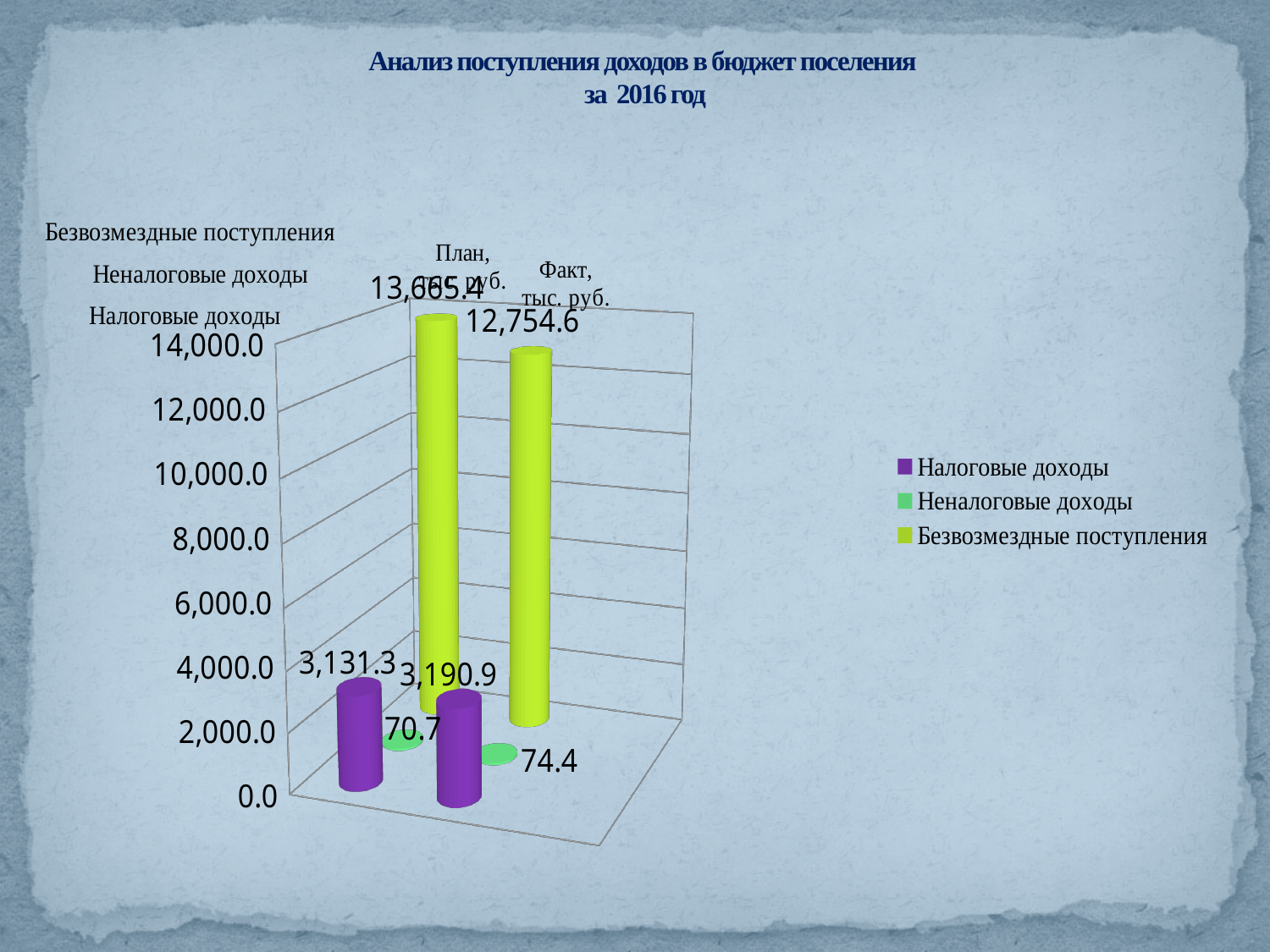
What is the difference between the План and Факт values for Безвозмездные поступления? 910.8 What kind of chart is shown on the slide? Bar chart Which series has the lowest value for План, тыс. руб.? Неналоговые доходы What is the value of Безвозмездные поступления for План, тыс. руб.? 13,665.4 Is the value of Безвозмездные поступления larger for План, тыс. руб. or for Факт, тыс. руб.? План, тыс. руб. What is the value of Налоговые доходы for Факт, тыс. руб.? 3,190.9 Which series has the highest value for Факт, тыс. руб.? Безвозмездные поступления What is the value of Неналоговые доходы for Факт, тыс. руб.? 74.4 What is the value of Налоговые доходы for План, тыс. руб.? 3,131.3 What is the value of Безвозмездные поступления for Факт, тыс. руб.? 12,754.6 How many series does the legend list? 3 What is the value of Неналоговые доходы for План, тыс. руб.? 70.7